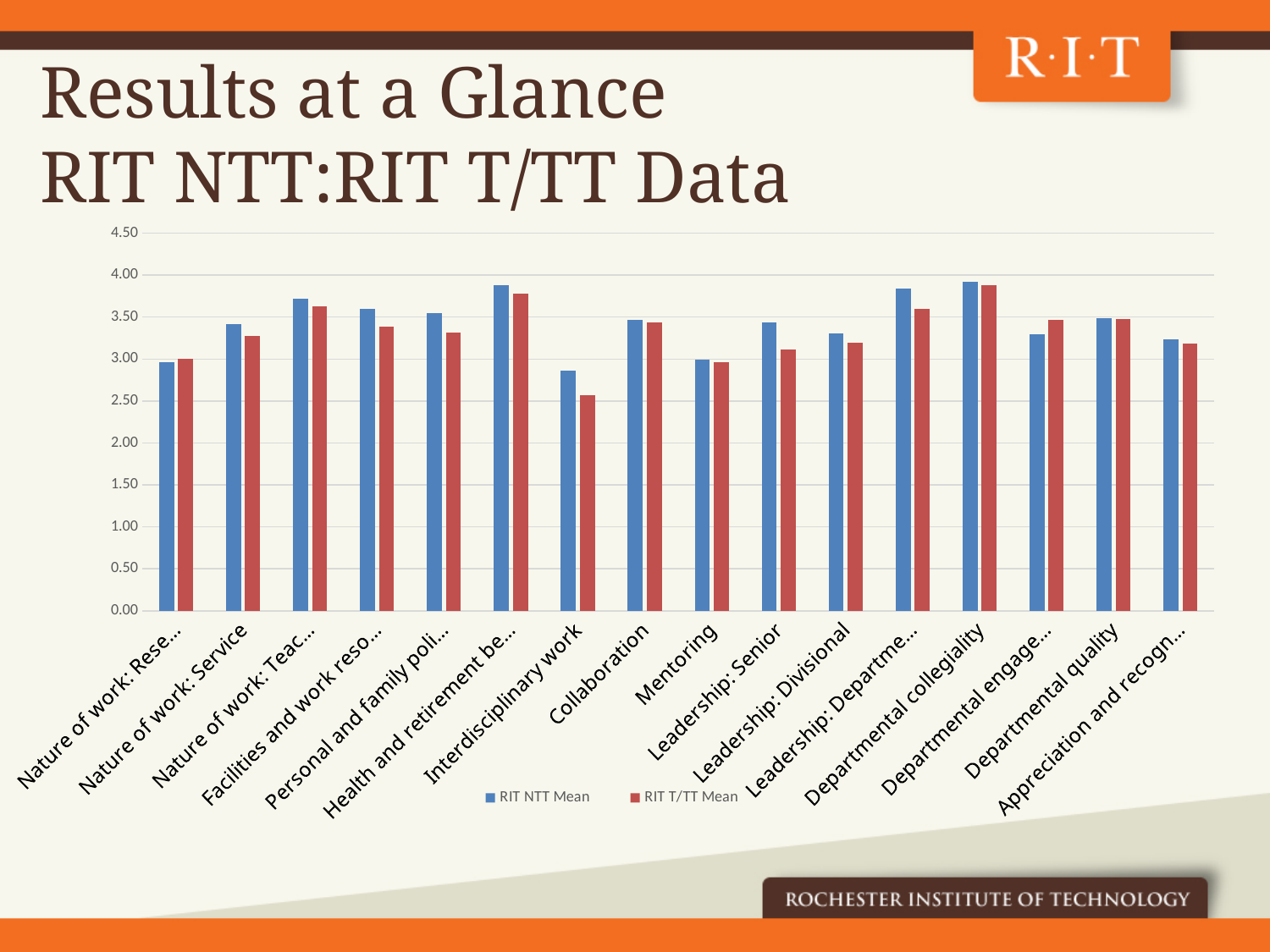
How many categories are plotted along the x axis? 16 Which category has the highest RIT NTT Mean? Departmental collegiality What kind of chart is shown on the slide? bar chart How many series does the legend list? 2 Is the RIT T/TT Mean for Interdisciplinary work greater or less than 3.00? less For Nature of work: Service, which is larger, the RIT NTT Mean or the RIT T/TT Mean? RIT NTT Mean Which category has the lowest RIT T/TT Mean? Interdisciplinary work Which category has the lowest RIT NTT Mean? Interdisciplinary work For Leadership: Senior, which is larger, the RIT NTT Mean or the RIT T/TT Mean? RIT NTT Mean Which colour represents the RIT T/TT Mean series? red What are the two series named in the legend? RIT NTT Mean and RIT T/TT Mean Is the RIT NTT Mean for Departmental collegiality greater or less than 3.50? greater